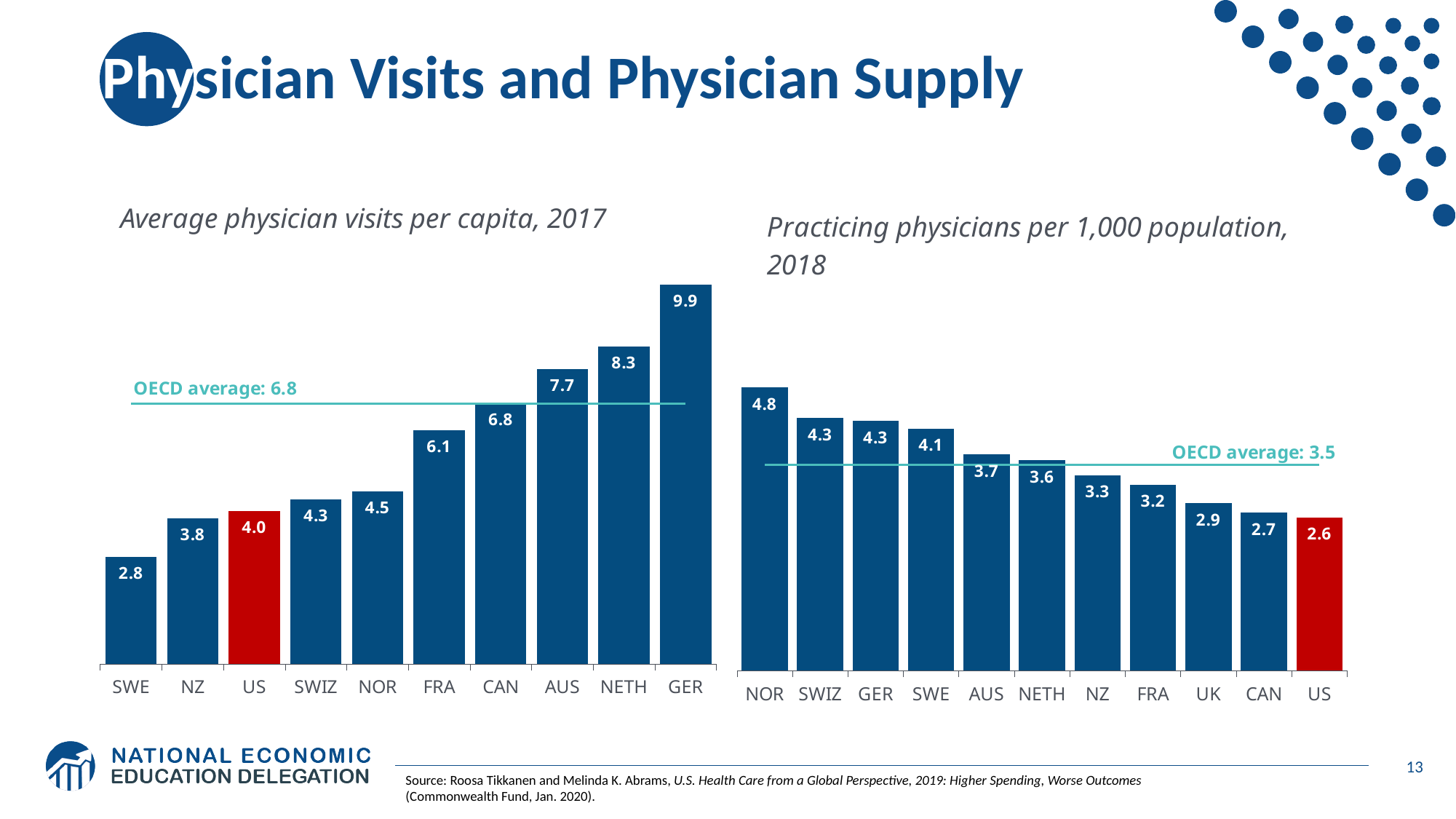
In the 'Practicing physicians per 1,000 population, 2018' chart, which is larger, the value for NETH or the value for UK? NETH In the 'Average physician visits per capita, 2017' chart, what is the value for the US? 4.0 In the 'Practicing physicians per 1,000 population, 2018' chart, which country has the lowest value? US In the 'Average physician visits per capita, 2017' chart, which country has the lowest value? SWE In the 'Average physician visits per capita, 2017' chart, how many countries are shown? 10 In the 'Average physician visits per capita, 2017' chart, what is the OECD average shown? 6.8 What type of chart is the 'Practicing physicians per 1,000 population, 2018' chart? Bar chart In the 'Practicing physicians per 1,000 population, 2018' chart, what is the value for NOR? 4.8 In the 'Average physician visits per capita, 2017' chart, which country has the highest value? GER In the 'Average physician visits per capita, 2017' chart, what is the difference between GER and the US? 5.9 In the 'Practicing physicians per 1,000 population, 2018' chart, what is the difference between NOR and the US? 2.2 In the 'Practicing physicians per 1,000 population, 2018' chart, how many countries are shown? 11